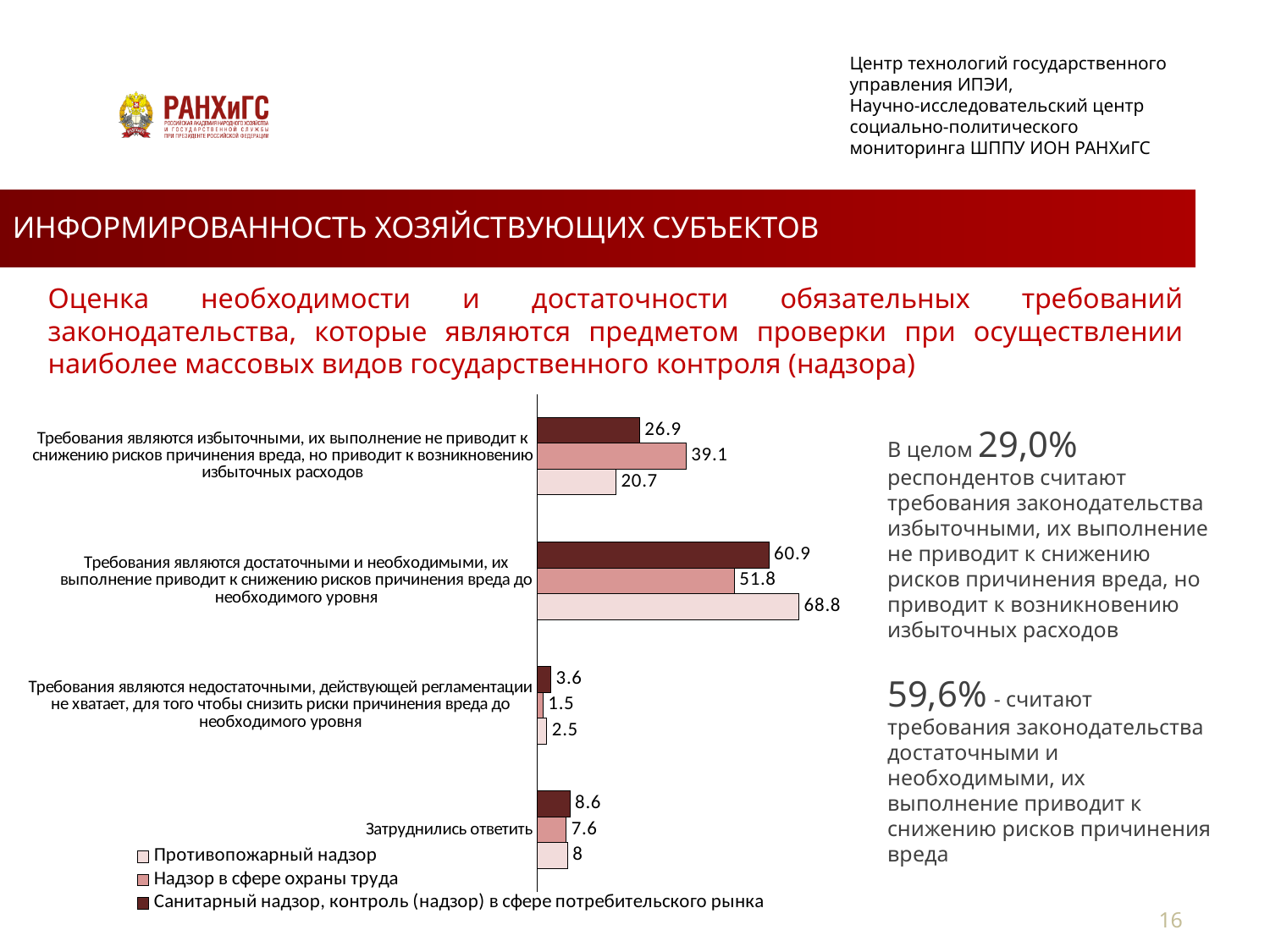
In the category «Требования являются избыточными...», which is larger: the value for «Санитарный надзор, контроль (надзор) в сфере потребительского рынка» or for «Противопожарный надзор»? Санитарный надзор, контроль (надзор) в сфере потребительского рынка What is the value for «Надзор в сфере охраны труда» in the category «Затруднились ответить»? 7.6 Which series has the lowest value in the category «Требования являются недостаточными...»? Надзор в сфере охраны труда How many series does the chart legend list? 3 What is the difference between the «Противопожарный надзор» and «Надзор в сфере охраны труда» values in the category «Требования являются достаточными и необходимыми...»? 17 What is the value for «Санитарный надзор, контроль (надзор) в сфере потребительского рынка» in the category «Требования являются недостаточными...»? 3.6 What is the value for «Противопожарный надзор» in the category «Затруднились ответить»? 8 How many categories are shown on the chart? 4 Which series has the highest value in the category «Требования являются достаточными и необходимыми...»? Противопожарный надзор What kind of chart is shown on the slide? bar chart What is the value for «Надзор в сфере охраны труда» in the category «Требования являются избыточными...»? 39.1 What is the value for «Противопожарный надзор» in the category «Требования являются достаточными и необходимыми...»? 68.8